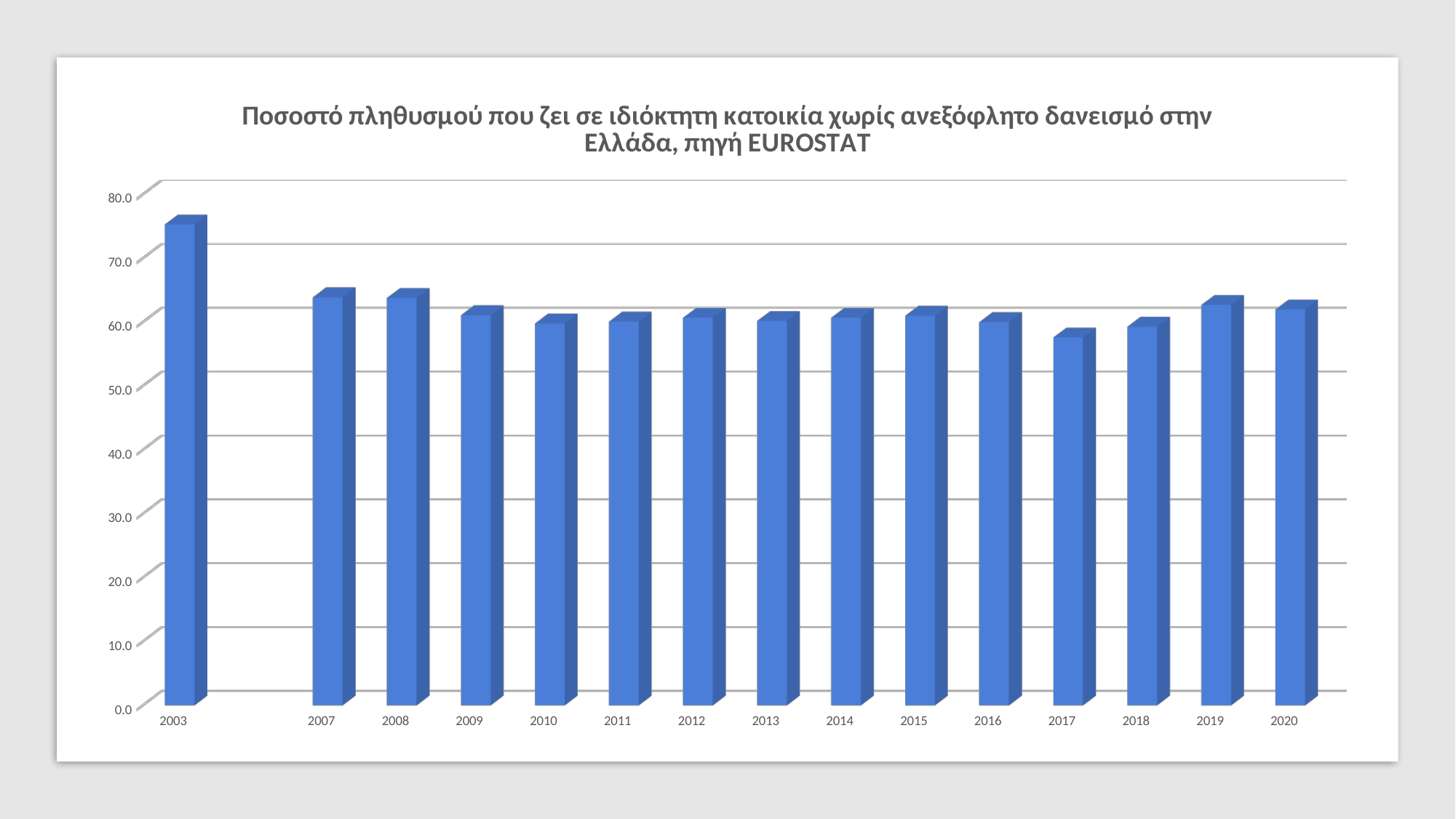
Which is larger, the value for 2003 or the value for 2007? 2003 What kind of chart is shown on the slide? bar chart Which year has the lowest value on the chart? 2017 Which is larger, the value for 2019 or the value for 2017? 2019 Is the value for 2003 greater or less than 80.0? less Which year has the highest value on the chart? 2003 Do the values rise or fall overall from 2007 to 2017? fall Is the value for 2007 greater or less than 60.0? greater How many years (bars) are plotted on the chart? 15 Is the value for 2017 greater or less than 60.0? less According to the chart title, what is the source of the data? EUROSTAT